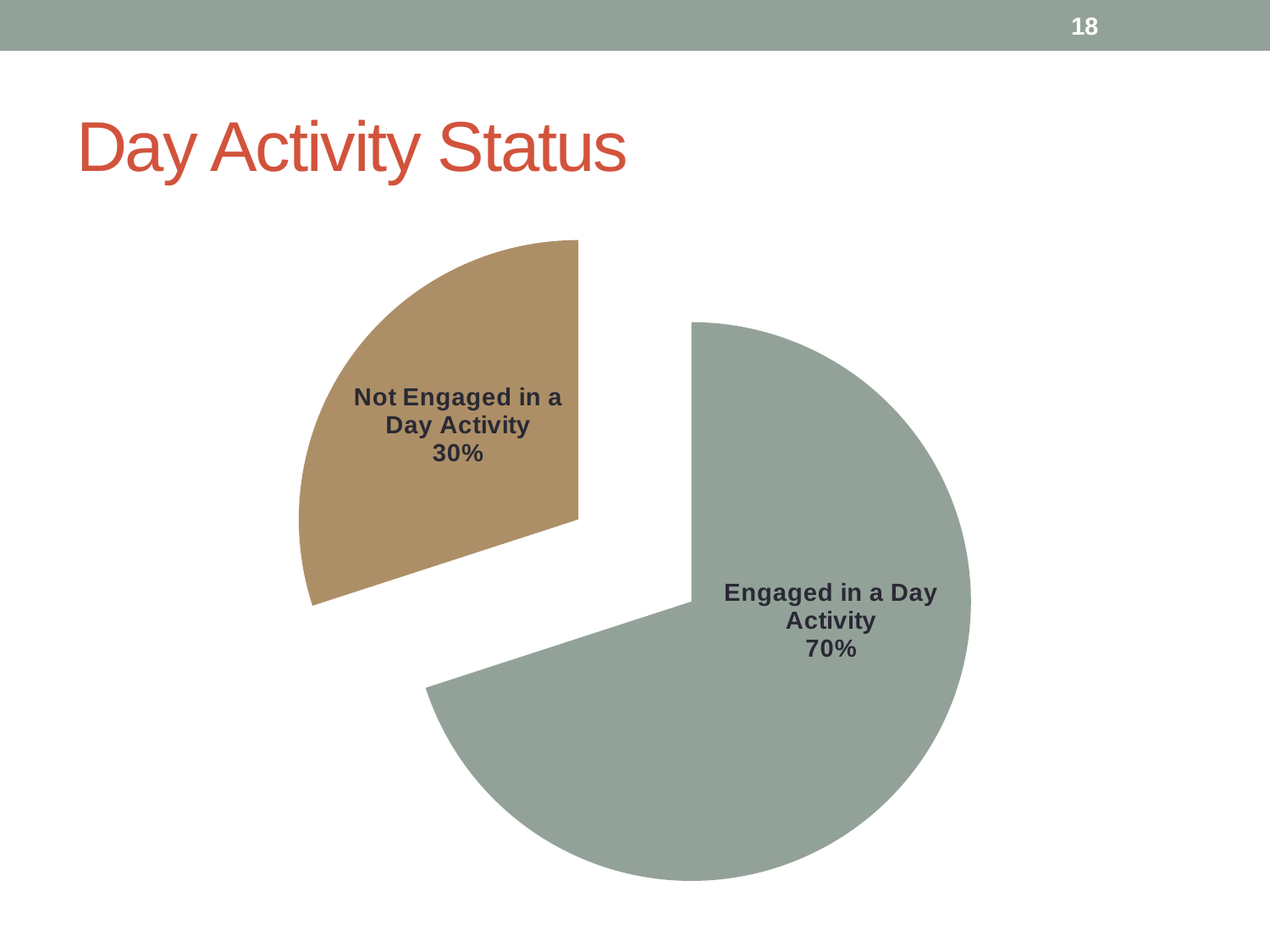
What percentage of the pie is labelled 'Not Engaged in a Day Activity'? 30% What kind of chart is shown on the slide? pie chart Which slice of the pie is the smallest? Not Engaged in a Day Activity Which slice of the pie is pulled out (exploded) from the rest of the chart? Not Engaged in a Day Activity What share of the pie does the 'Not Engaged in a Day Activity' slice represent? 30% What percentage of the pie is labelled 'Engaged in a Day Activity'? 70% Which is larger: the 'Engaged in a Day Activity' slice or the 'Not Engaged in a Day Activity' slice? Engaged in a Day Activity Which slice of the pie is the largest? Engaged in a Day Activity What is the title of the slide containing the pie chart? Day Activity Status How many slices does the pie chart have? 2 What is the difference in percentage points between the 'Engaged in a Day Activity' slice and the 'Not Engaged in a Day Activity' slice? 40